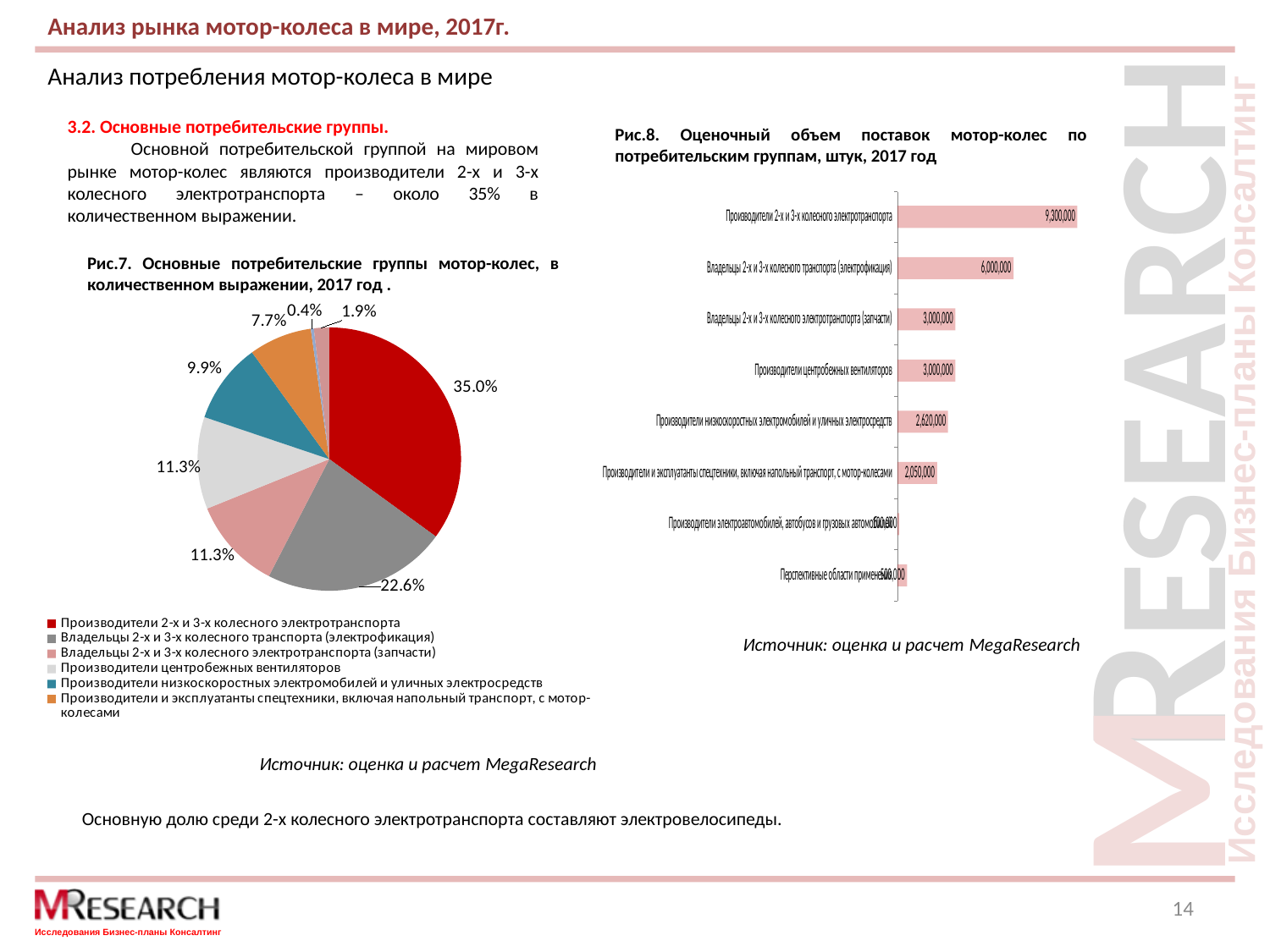
In Рис.7, what share of the pie belongs to Владельцы 2-х и 3-х колесного транспорта (электрофикация)? 22.6% How many categories (bars) are shown in Рис.8? 8 In Рис.7, what is the percentage of the smallest slice? 0.4% In Рис.8, which consumer group has the highest supply volume? Производители 2-х и 3-х колесного электротранспорта In Рис.8, what is the value for Владельцы 2-х и 3-х колесного транспорта (электрофикация)? 6,000,000 What kind of chart is Рис.7 (Основные потребительские группы мотор-колес)? pie chart In Рис.8, which is larger: Производители центробежных вентиляторов or Производители и эксплуатанты спецтехники, включая напольный транспорт, с мотор-колесами? Производители центробежных вентиляторов In Рис.8, what is the value for Производители низкоскоростных электромобилей и уличных электросредств? 2,620,000 In Рис.7, what share of the pie belongs to Производители 2-х и 3-х колесного электротранспорта? 35.0% In Рис.8, what is the difference between Производители 2-х и 3-х колесного электротранспорта and Владельцы 2-х и 3-х колесного транспорта (электрофикация)? 3,300,000 In Рис.8, what is the value for Производители 2-х и 3-х колесного электротранспорта? 9,300,000 What kind of chart is Рис.8 (Оценочный объем поставок мотор-колес по потребительским группам)? bar chart